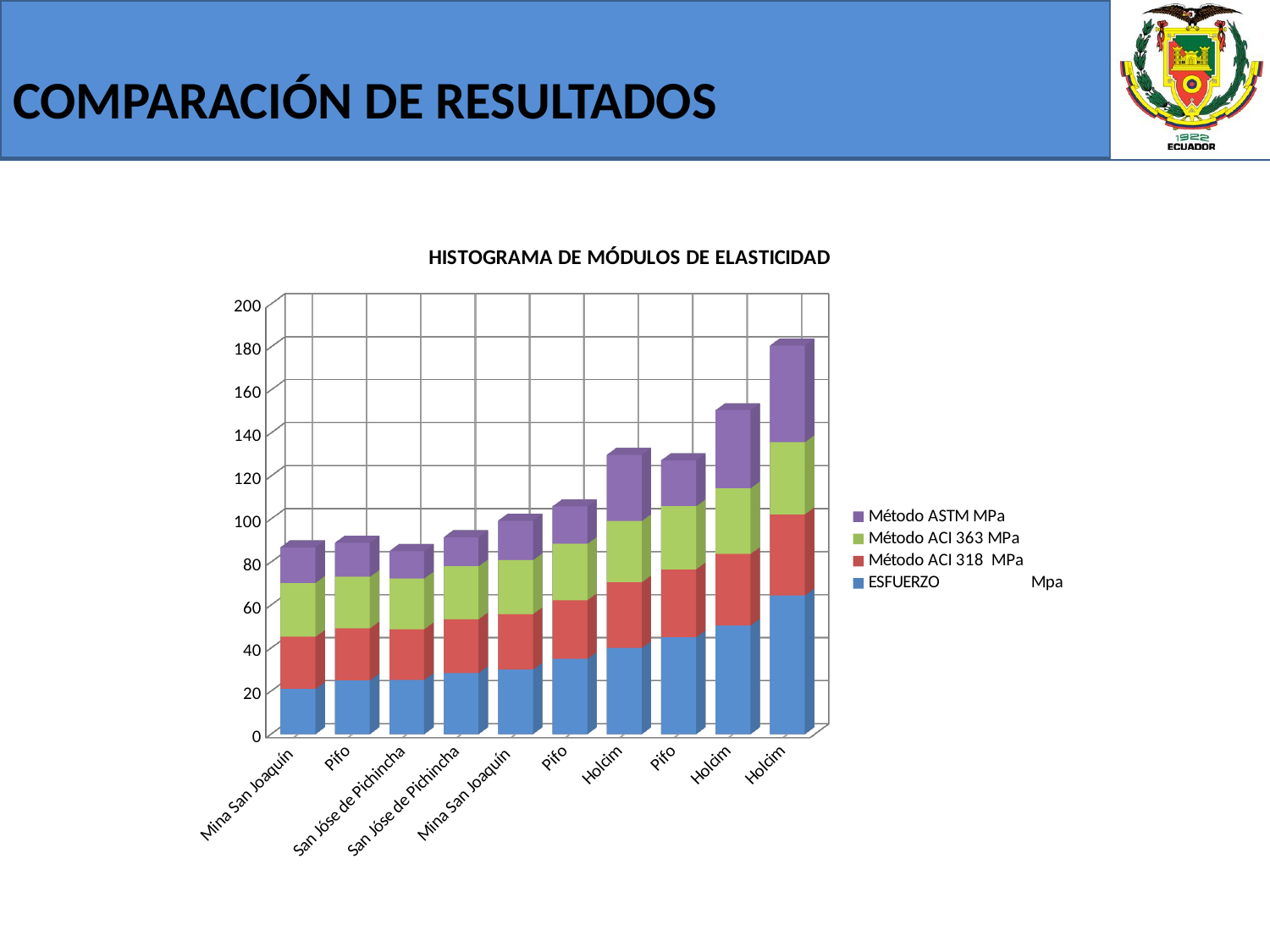
Which has a larger total: the rightmost Holcim bar or the leftmost Mina San Joaquín bar? The rightmost Holcim bar Which bar has the highest total? The rightmost Holcim bar What is the title of the chart? HISTOGRAMA DE MÓDULOS DE ELASTICIDAD Is the total of the leftmost bar (Mina San Joaquín) greater or less than 100? less Is the ESFUERZO value for the rightmost bar (Holcim) greater or less than 60? greater Is the total of the seventh bar from the left (Holcim) greater or less than 120? greater Which series is shown in purple at the top of each stacked bar? Método ASTM MPa Do the stacked bar totals generally rise or fall from left to right along the x axis? Rise What type of chart is shown on the slide? Stacked bar chart How many series does the chart's legend list? 4 How many bars are plotted in the chart? 10